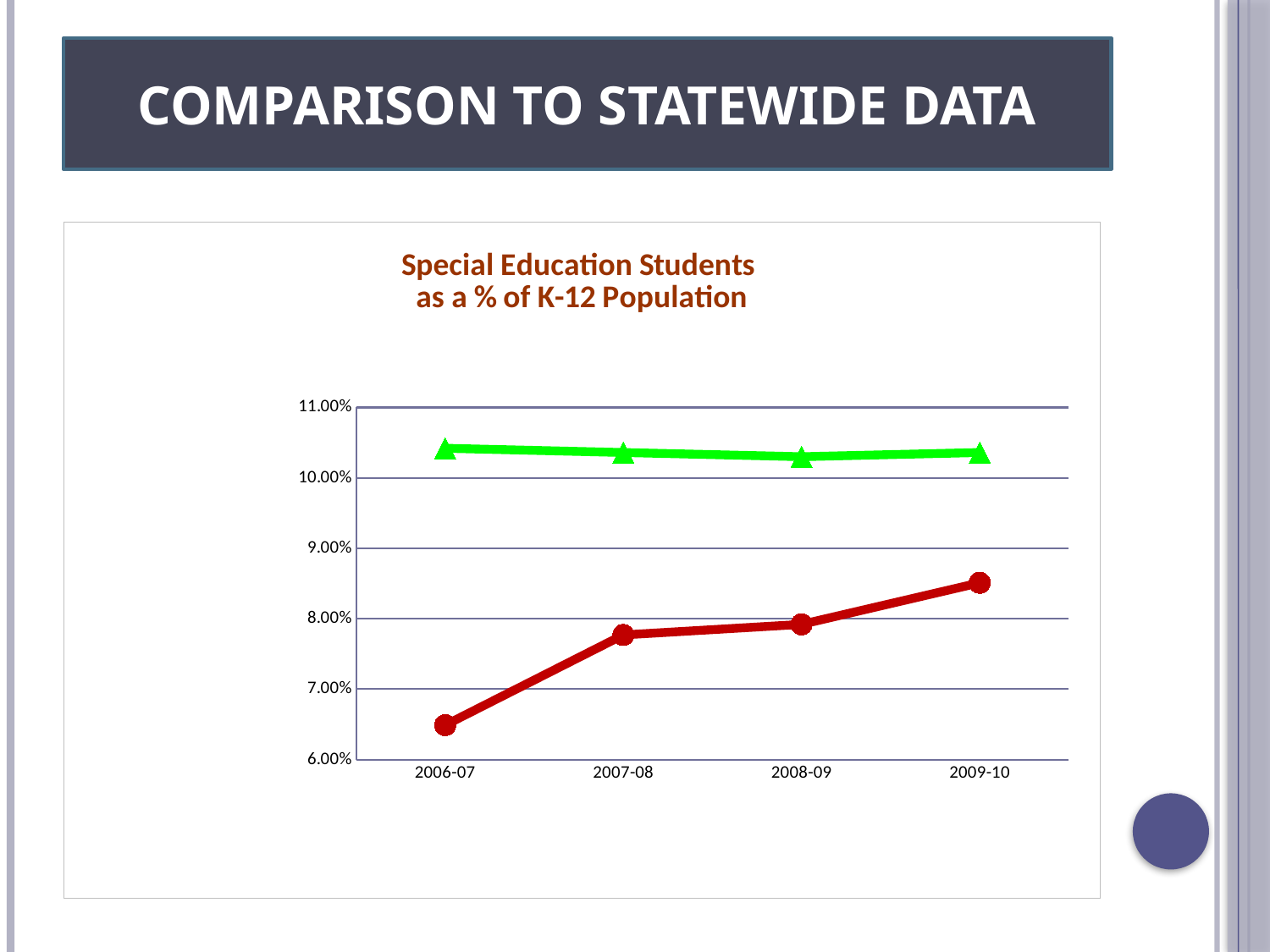
Is the value of the red line with circle markers for 2007-08 greater or less than 8.00%? less In 2009-10, which line has the higher value, the green line with triangle markers or the red line with circle markers? the green line with triangle markers Is the value of the red line with circle markers for 2009-10 greater or less than 8.00%? greater Does the red line with circle markers rise or fall from 2006-07 to 2009-10? rise Is the value of the green line with triangle markers for 2006-07 greater or less than 10.00%? greater What is the title of the chart? Special Education Students as a % of K-12 Population How many lines are plotted on the chart? 2 In which school year is the red line with circle markers at its lowest? 2006-07 In which school year is the red line with circle markers at its highest? 2009-10 What kind of chart is shown on the slide? line chart How many school years are shown on the x axis? 4